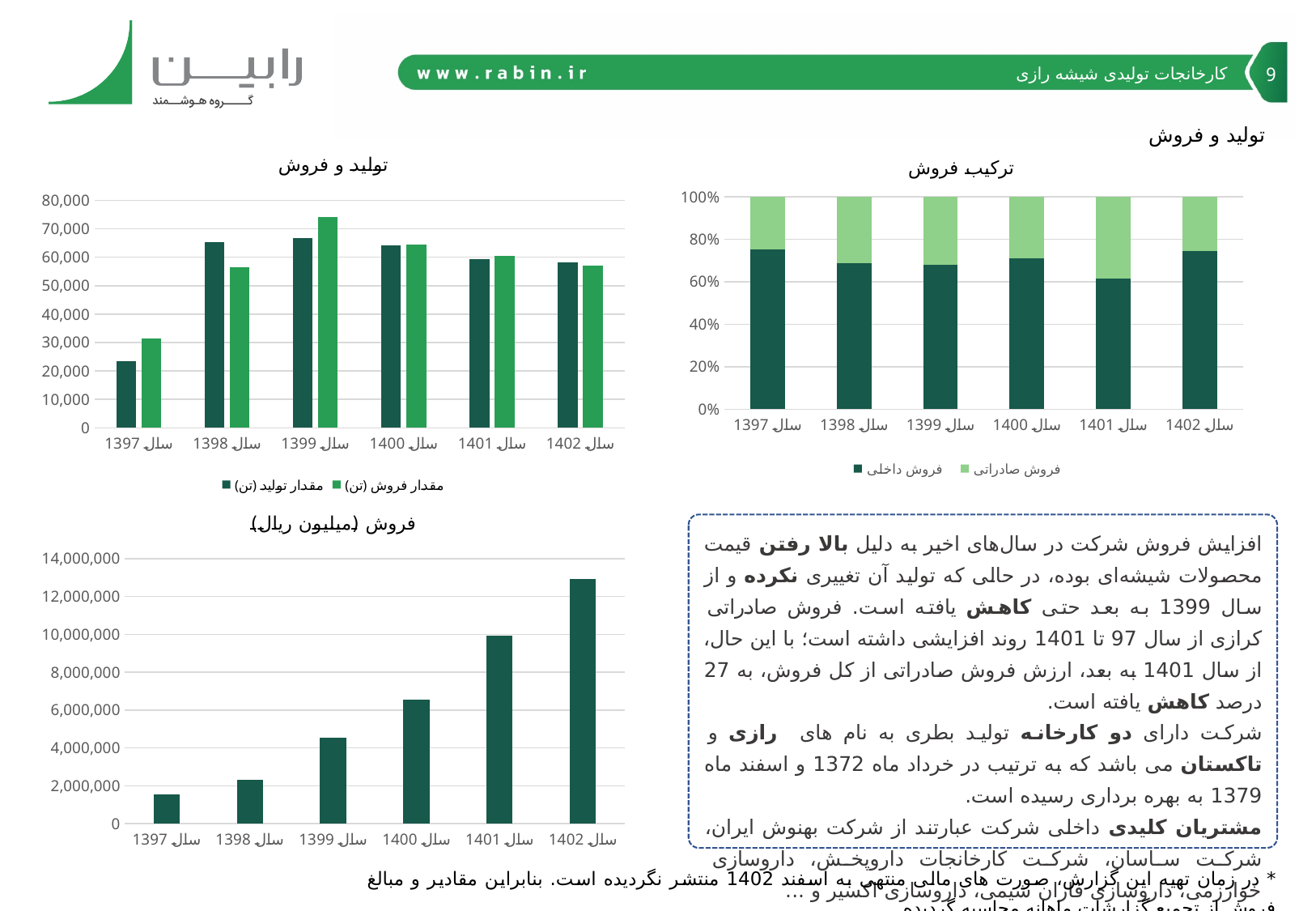
In the chart titled "فروش (میلیون ریال)", is the value for سال 1402 greater or less than 12,000,000? greater In the chart titled "ترکیب فروش", which year has the lowest share of فروش داخلی? سال 1401 In the chart titled "تولید و فروش", how many years are shown on the x axis? 6 In the chart titled "تولید و فروش", is the value of مقدار تولید (تن) for سال 1397 greater or less than 30,000? less In the chart titled "تولید و فروش", which year has the lowest value for مقدار تولید (تن)? سال 1397 In the chart titled "ترکیب فروش", which series is shown in the lighter green colour? فروش صادراتی In the chart titled "ترکیب فروش", is the share of فروش داخلی for سال 1401 greater or less than 80%? less What kind of chart is the chart titled "فروش (میلیون ریال)"? bar chart In the chart titled "فروش (میلیون ریال)", do the values rise or fall from سال 1397 to سال 1402? rise In the chart titled "تولید و فروش", which year has the highest value for مقدار فروش (تن)? سال 1399 In the chart titled "تولید و فروش", how many series does the legend list? 2